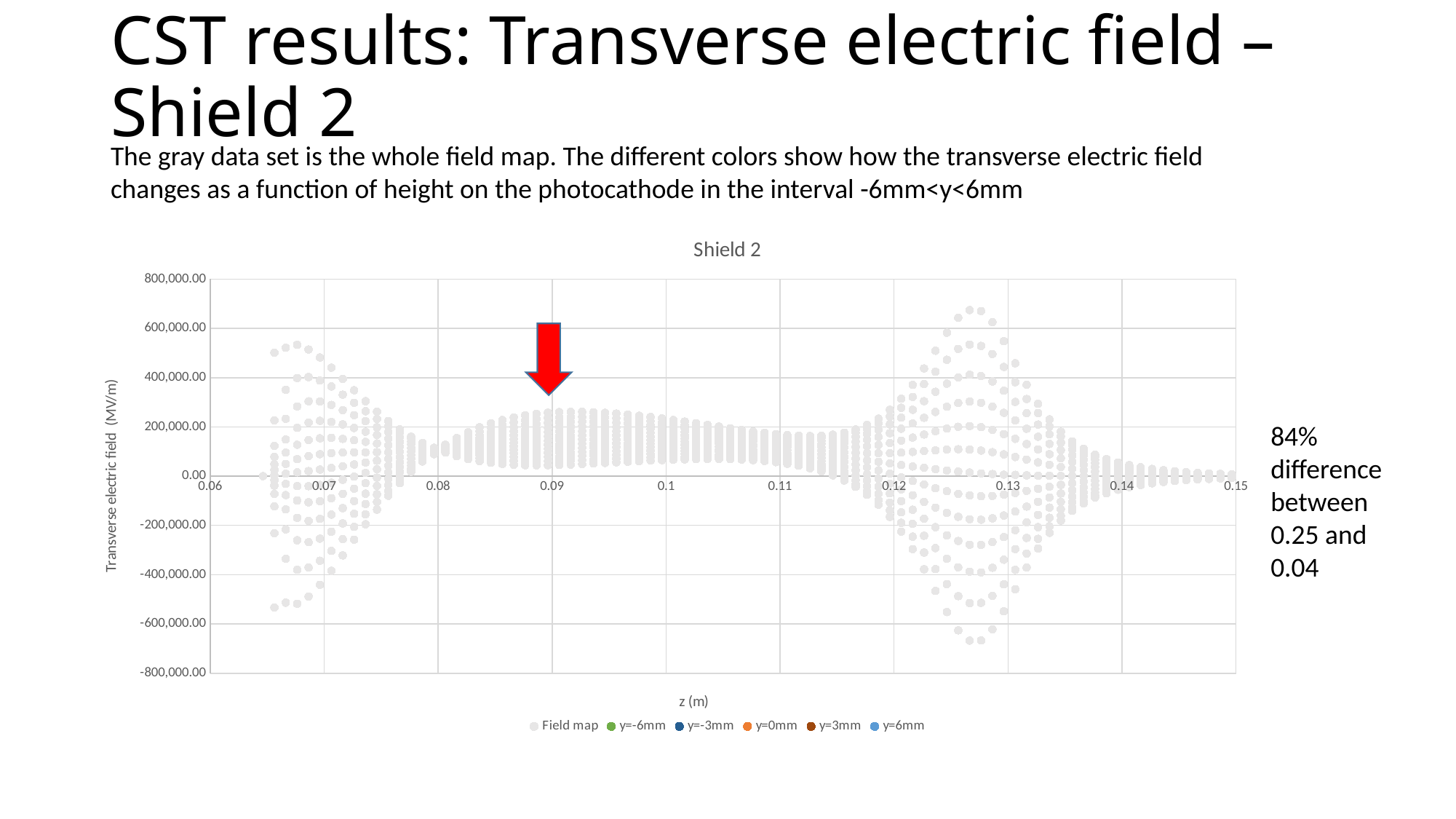
Which region has the larger peak field map value: around z = 0.07 or around z = 0.13? around z = 0.13 Is the highest field map value near z = 0.13 greater or less than 600,000.00? greater Which series in the legend is plotted in gray? Field map What is the title of the chart? Shield 2 Is the highest field map value near z = 0.09 (where the red arrow points) greater or less than 200,000.00? greater Is the highest field map value near z = 0.07 greater or less than 400,000.00? greater What kind of chart is shown on the slide? scatter chart How many series does the legend of the Shield 2 chart list? 6